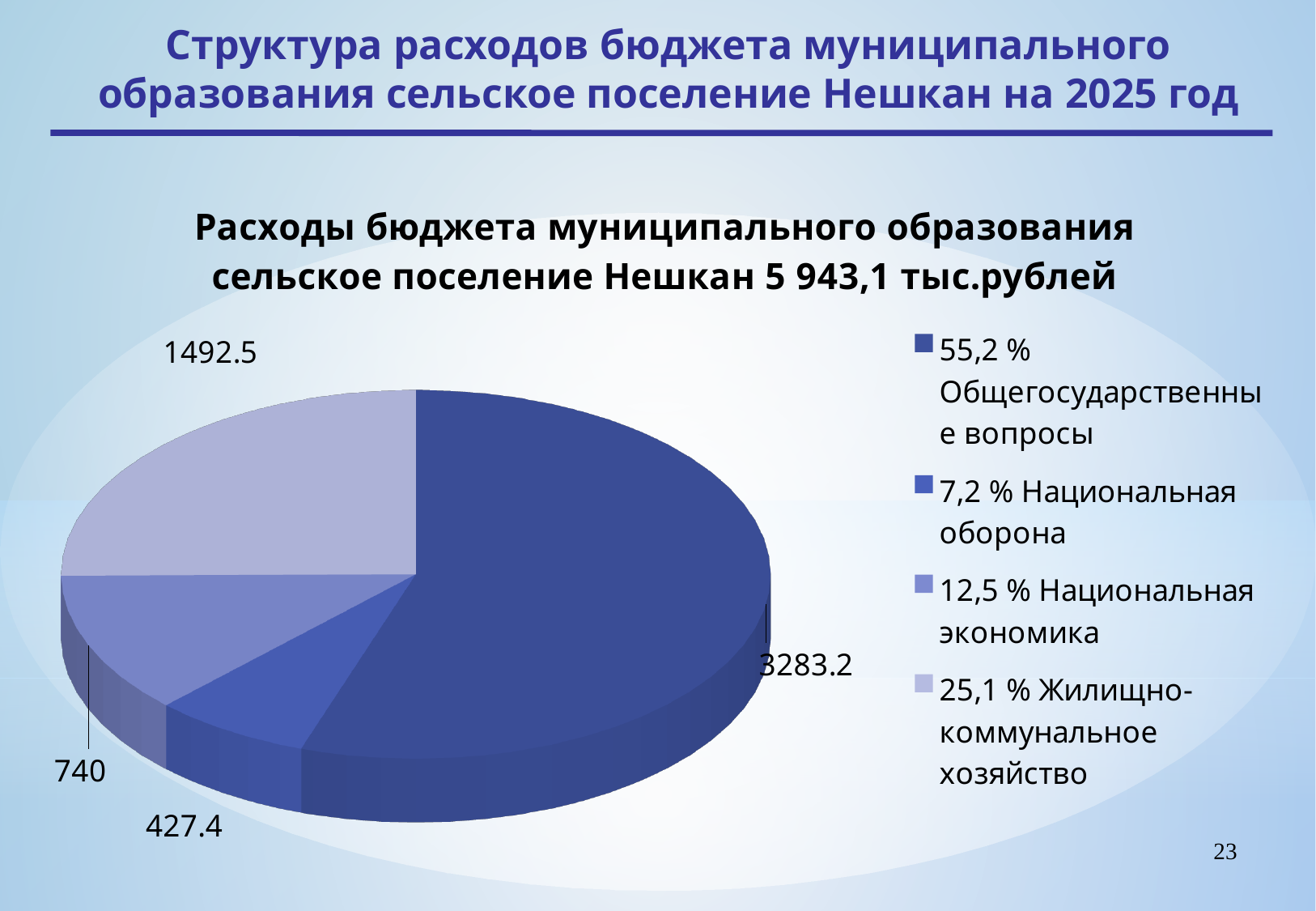
What share of the pie does Жилищно-коммунальное хозяйство represent? 25,1 % How many slices does the pie chart have? 4 What is the difference between the values for Национальная экономика and Национальная оборона? 312.6 Which category has the largest slice of the pie? Общегосударственные вопросы Which is larger, the value for Национальная экономика or the value for Национальная оборона? Национальная экономика What kind of chart is shown on the slide? pie chart What is the value for Общегосударственные вопросы? 3283.2 Which category has the smallest slice of the pie? Национальная оборона What is the value for Национальная оборона? 427.4 What is the value for Жилищно-коммунальное хозяйство? 1492.5 What is the difference between the values for Общегосударственные вопросы and Жилищно-коммунальное хозяйство? 1790.7 What is the value for Национальная экономика? 740